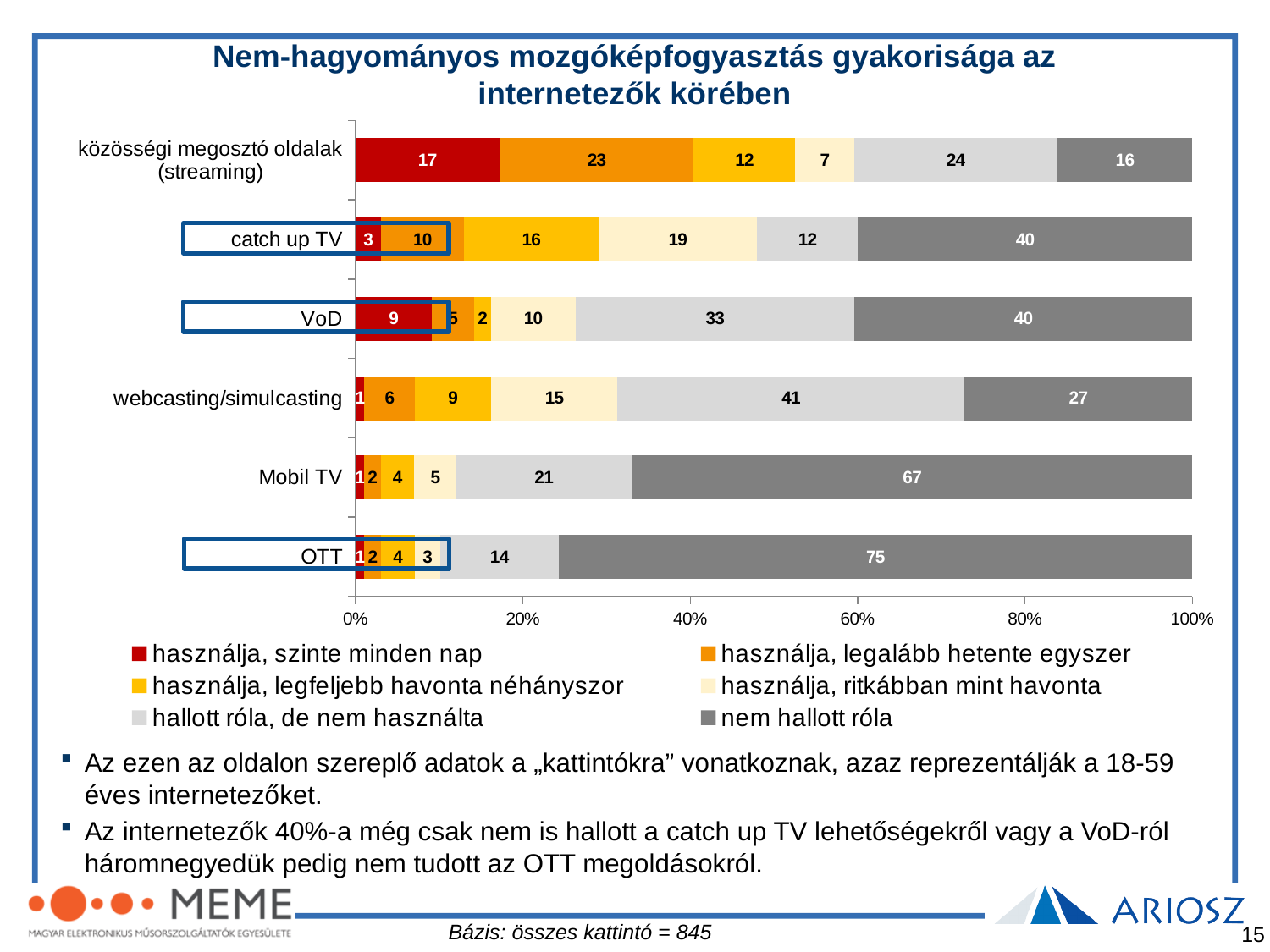
How many series does the legend list? 6 Which is larger: the "hallott róla, de nem használta" value for VoD or for közösségi megosztó oldalak (streaming)? VoD What is the value for "nem hallott róla" for Mobil TV? 67 What is the value for "nem hallott róla" for catch up TV? 40 Which category has the highest value for "nem hallott róla"? OTT Which category has the lowest value for "nem hallott róla"? közösségi megosztó oldalak (streaming) What is the difference between the "nem hallott róla" values for OTT and Mobil TV? 8 How many categories are shown on the chart? 6 What is the value for "hallott róla, de nem használta" for webcasting/simulcasting? 41 What is the value for "használja, szinte minden nap" for közösségi megosztó oldalak (streaming)? 17 What kind of chart is shown on the slide? Stacked bar chart What is the value for "használja, ritkábban mint havonta" for catch up TV? 19